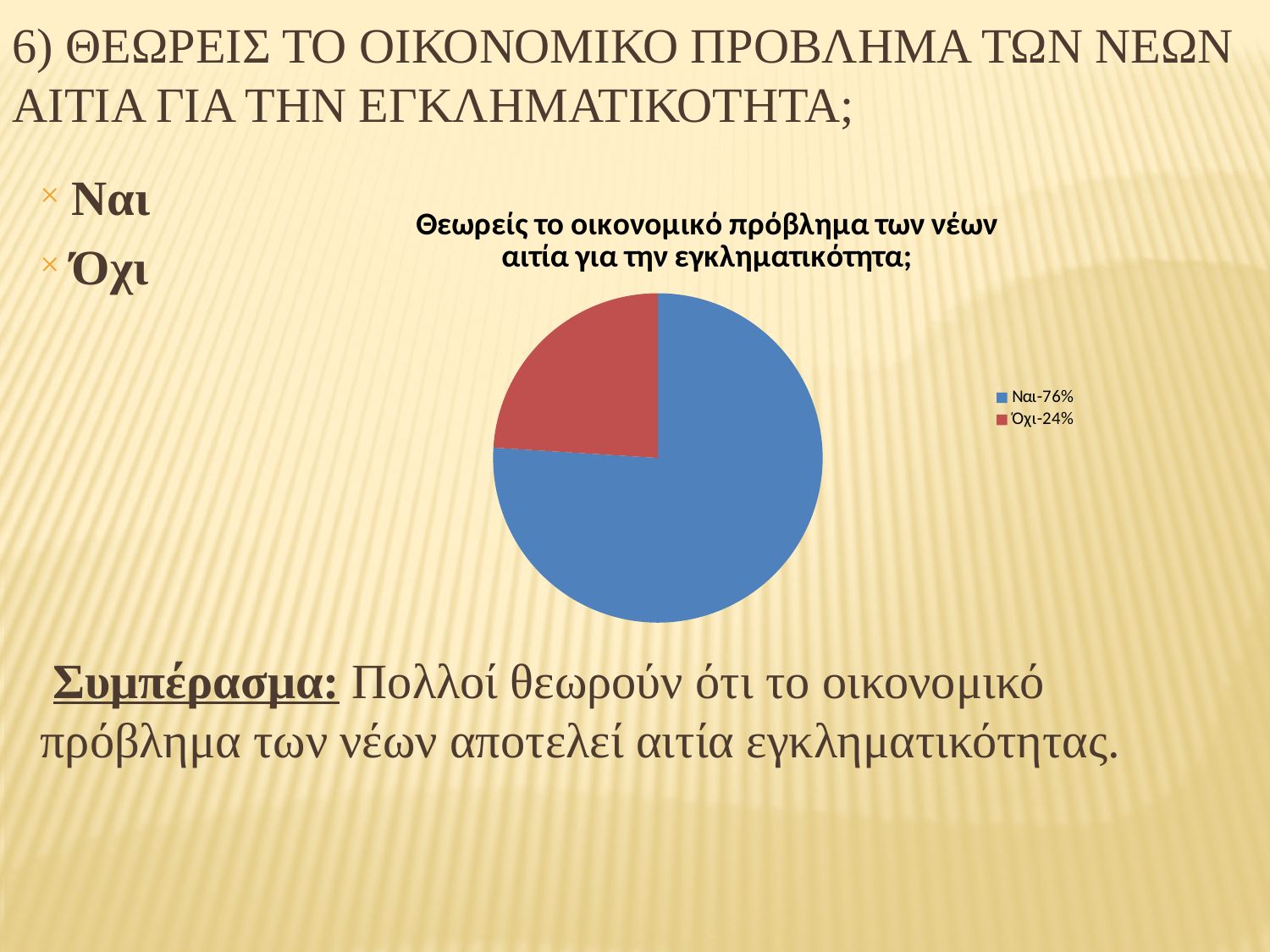
What kind of chart is shown on the slide? pie chart How many entries does the legend list? 2 How many slices does the pie chart have? 2 Which is larger, the "Ναι" slice or the "Όχι" slice? Ναι What share of the pie does the "Όχι" slice represent? 24% Which slice of the pie is the smallest? Όχι What is the title of the pie chart? Θεωρείς το οικονομικό πρόβλημα των νέων αιτία για την εγκληματικότητα; What is the difference in percentage points between the "Ναι" and "Όχι" slices? 52 Which slice of the pie is the largest? Ναι What colour is the "Όχι" slice in the pie chart? red What share of the pie does the "Ναι" slice represent? 76%